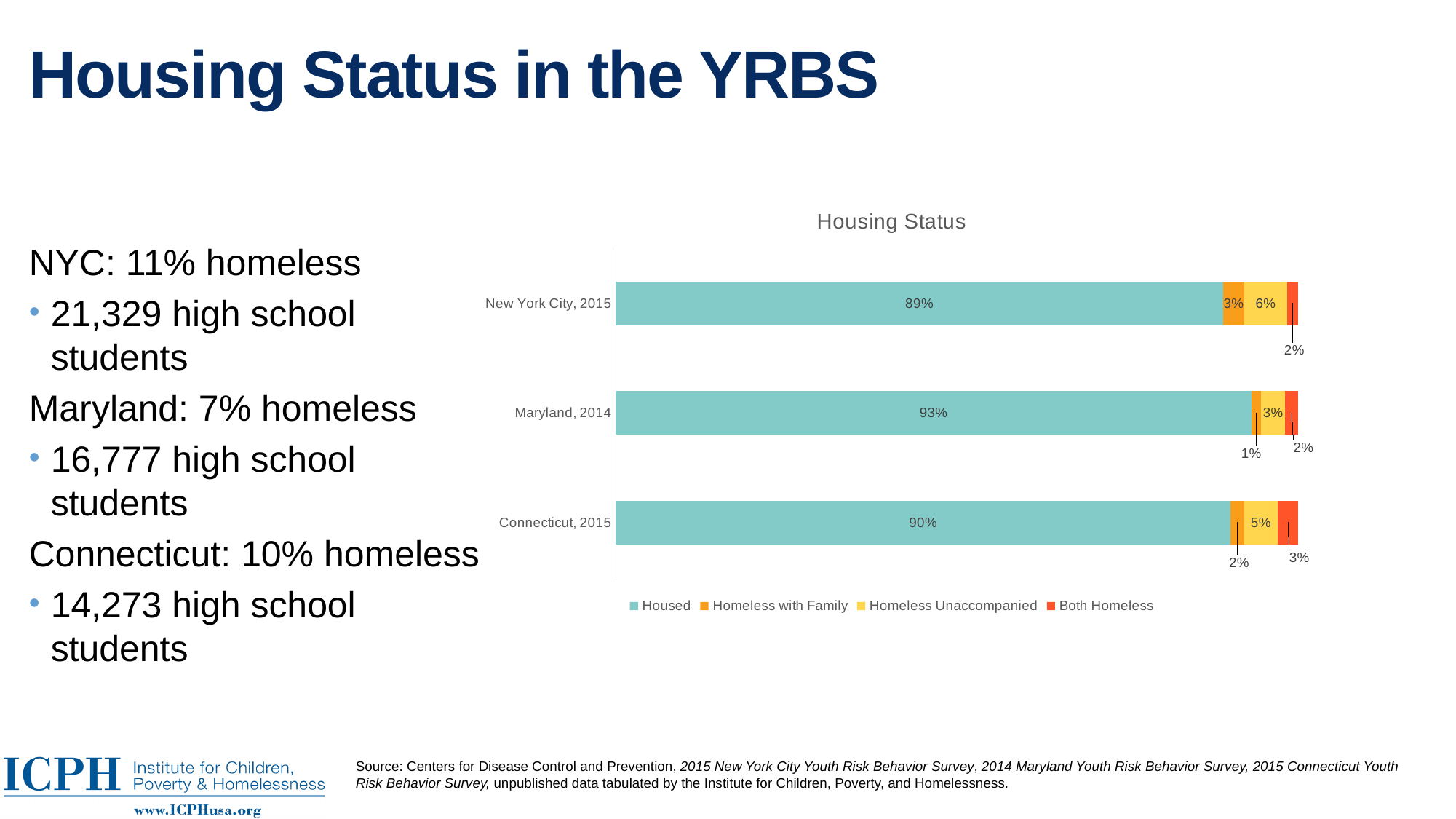
In the Housing Status chart, what is the Both Homeless value for Connecticut, 2015? 3% In the Housing Status chart, what percentage of New York City, 2015 students are Housed? 89% How many categories are shown in the Housing Status chart? 3 Which has a larger Homeless with Family value, New York City, 2015 or Connecticut, 2015? New York City, 2015 In the Housing Status chart, what is the Homeless Unaccompanied value for Connecticut, 2015? 5% In the Housing Status chart, what is the Homeless with Family value for Maryland, 2014? 1% What is the title of the chart on the slide? Housing Status Which category has the highest Housed percentage in the Housing Status chart? Maryland, 2014 How many series does the legend of the Housing Status chart list? 4 What type of chart is shown on the slide? Stacked bar chart Which category has the lowest Housed percentage in the Housing Status chart? New York City, 2015 What is the difference between the Homeless Unaccompanied values for New York City, 2015 and Maryland, 2014? 3%